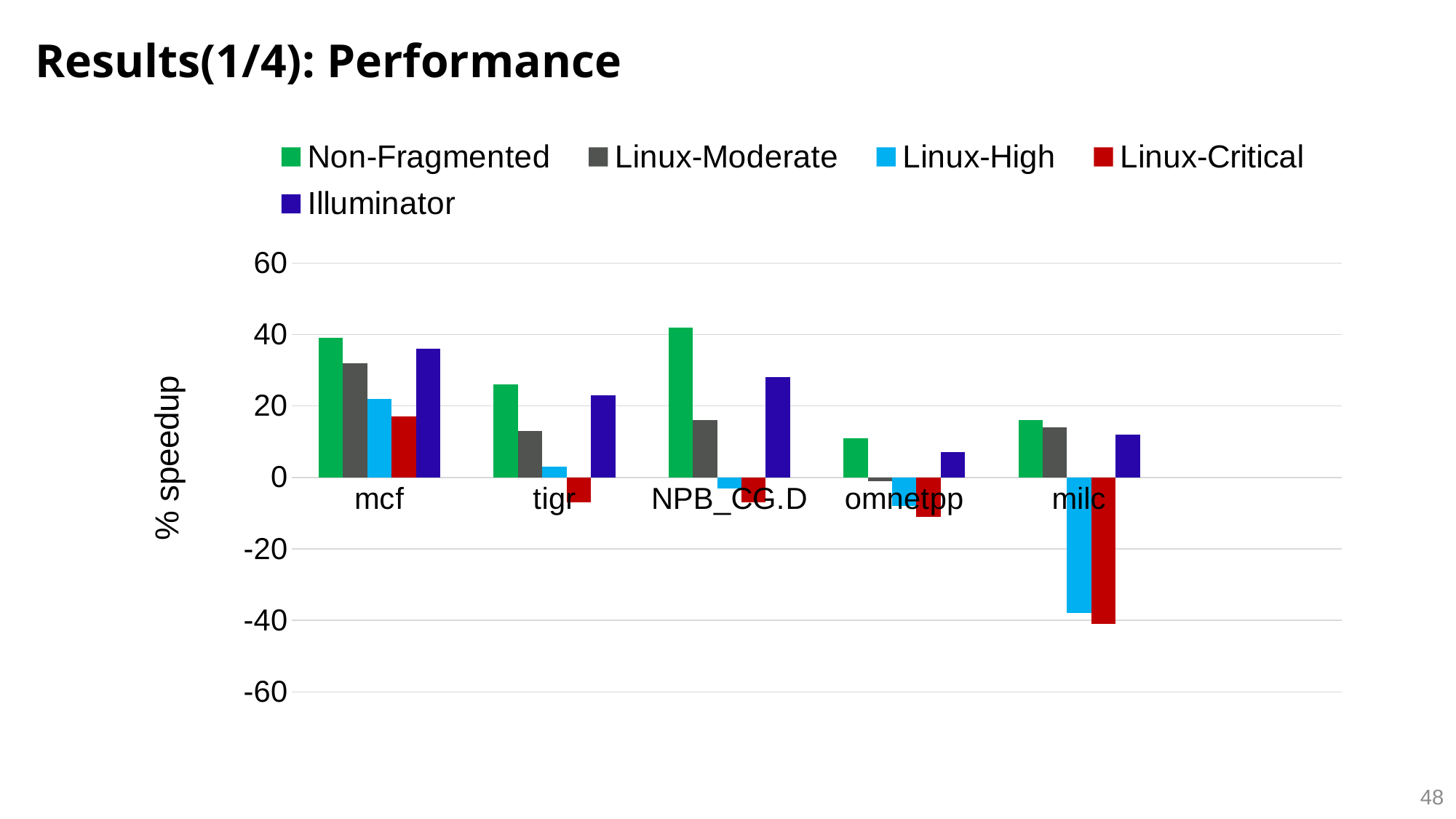
Is the Non-Fragmented value for mcf greater or less than 20? greater What kind of chart is shown on the slide? bar chart How many benchmark categories are shown on the x axis? 5 Which benchmark has the lowest Linux-Critical value? milc Which benchmark has the highest Non-Fragmented value? NPB_CG.D Which benchmark has the lowest Linux-High value? milc For milc, which is larger: Illuminator or Linux-Critical? Illuminator How many series does the legend list? 5 Is the Illuminator value for NPB_CG.D greater or less than 20? greater What is the label on the y axis? % speedup For mcf, which is larger: Linux-Moderate or Linux-High? Linux-Moderate Is the Linux-High value for milc greater or less than -20? less